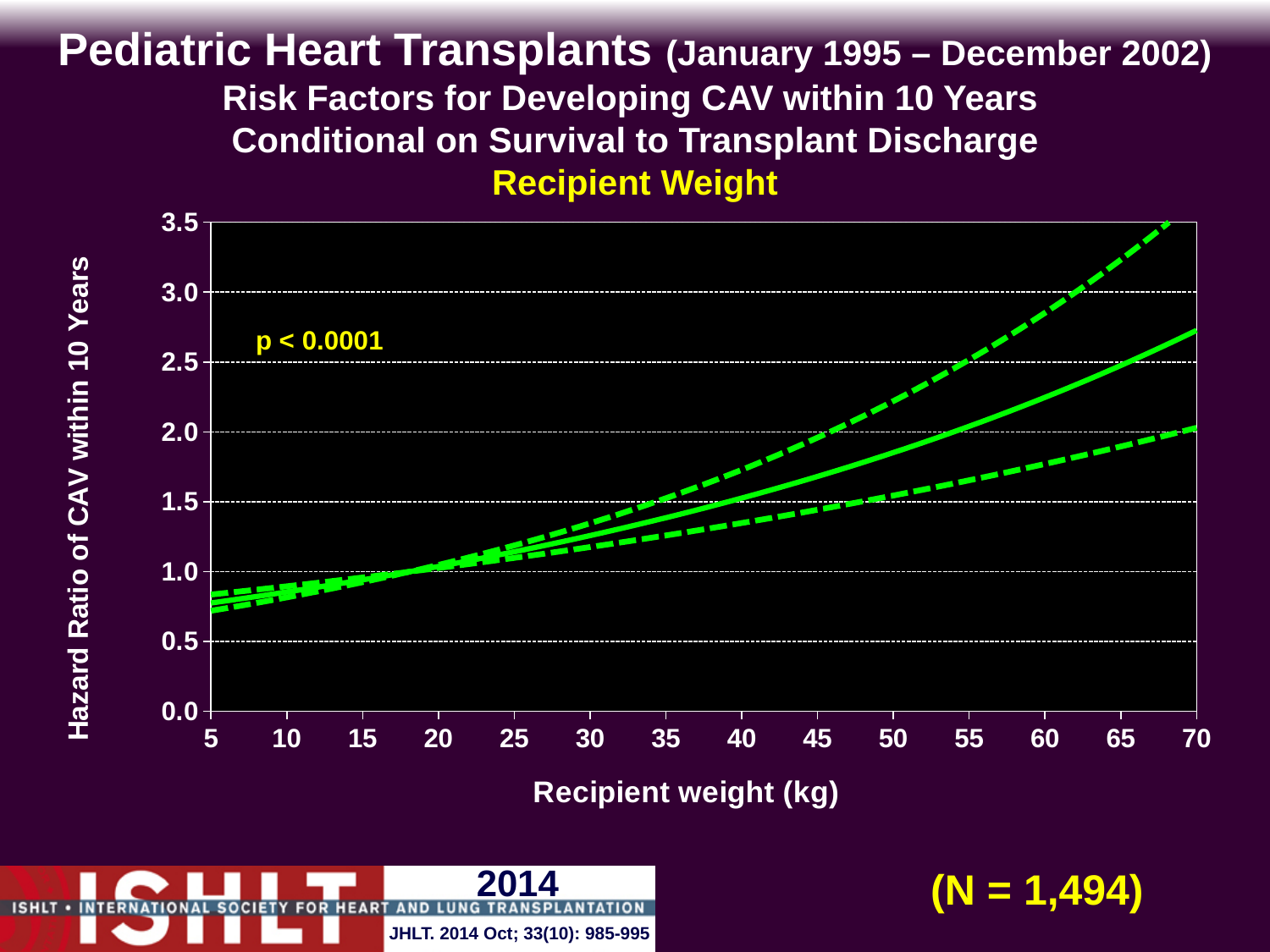
What is the label of the x axis? Recipient weight (kg) What kind of chart is shown on the slide? Line chart How many lines are plotted on the chart? 3 What is the p-value shown on the chart? p < 0.0001 Is the upper dashed line at 60 kg greater or less than 2.5? greater Is the lower dashed line at 60 kg greater or less than 1.5? greater Is the hazard ratio on the solid line at 30 kg greater or less than 1.0? greater Does the hazard ratio (solid line) rise or fall as recipient weight increases from 5 kg to 70 kg? Rise